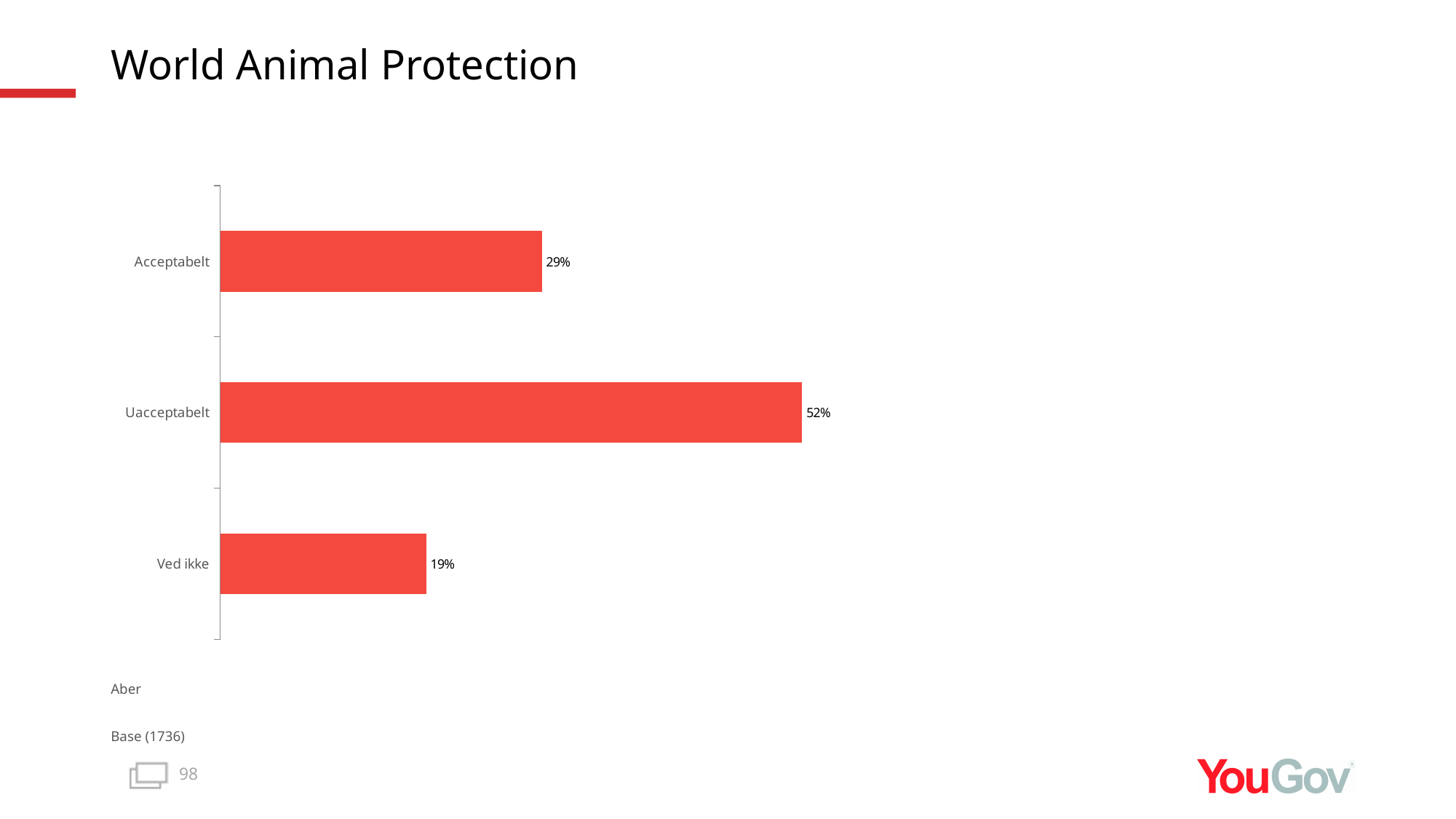
What is the difference between the values for Uacceptabelt and Acceptabelt? 23% How many categories are shown in the chart? 3 What is the value for Uacceptabelt? 52% What is the value for Acceptabelt? 29% Which category has the highest value? Uacceptabelt What is the difference between the values for Acceptabelt and Ved ikke? 10% What is the value for Ved ikke? 19% Which category has the lowest value? Ved ikke Which is larger, the value for Acceptabelt or the value for Ved ikke? Acceptabelt What kind of chart is shown on the slide? Bar chart What is the title of the slide? World Animal Protection What base size is stated below the chart? 1736